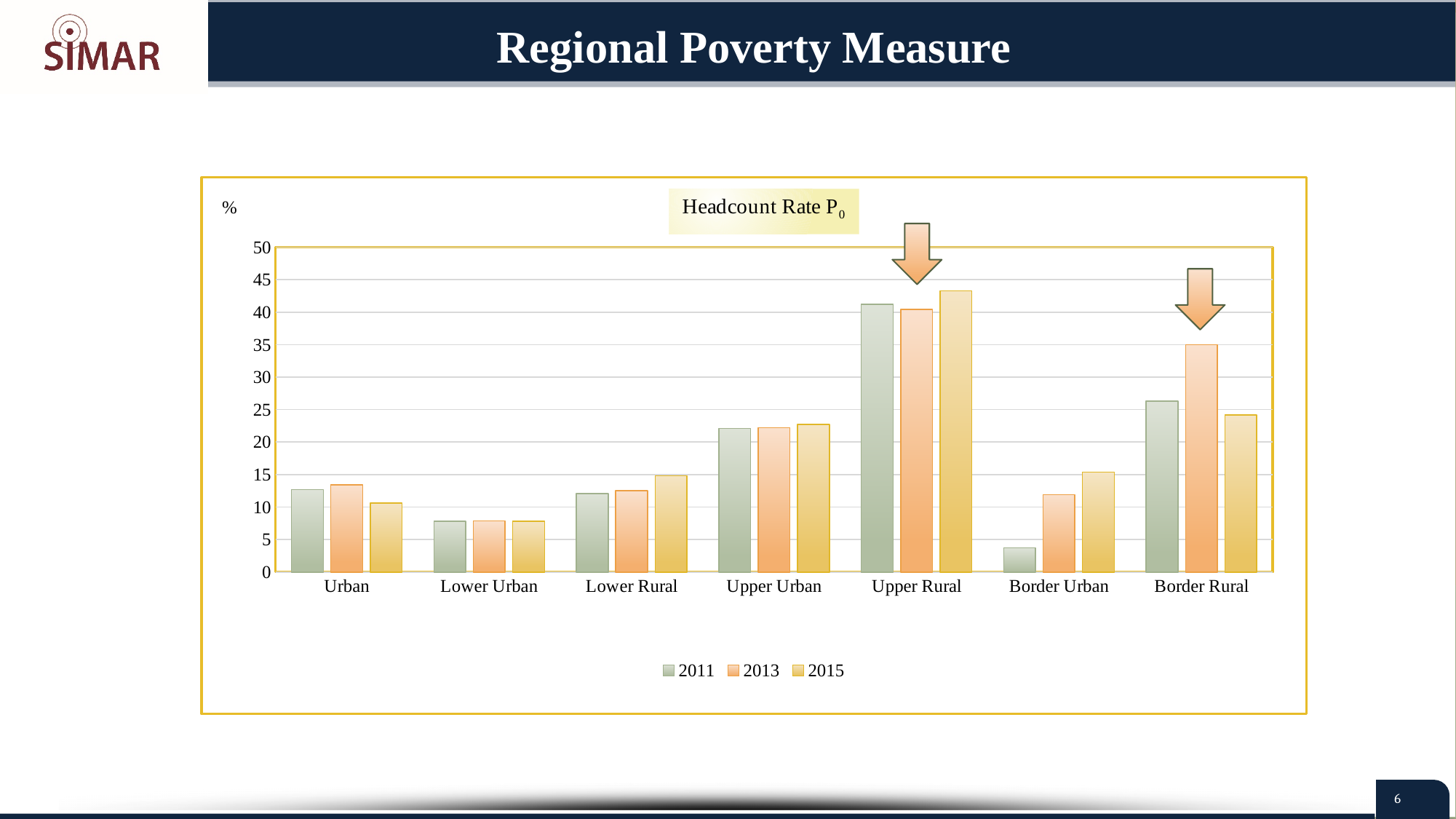
Which years are listed in the chart's legend? 2011, 2013, 2015 How many regional categories are shown on the x axis of the chart? 7 Is the 2013 value for Border Rural greater or less than 30? greater For Border Urban, do the values rise or fall from 2011 to 2015? rise Is the 2011 value for Border Urban greater or less than 5? less How many series does the chart's legend list? 3 For Border Rural, which is larger: the 2013 value or the 2015 value? 2013 Is the 2015 value for Upper Rural greater or less than 40? greater What is the title shown above the chart? Headcount Rate P0 Which category has the lowest value for 2011? Border Urban What kind of chart is shown on the slide? bar chart Which category has the highest value for 2015? Upper Rural